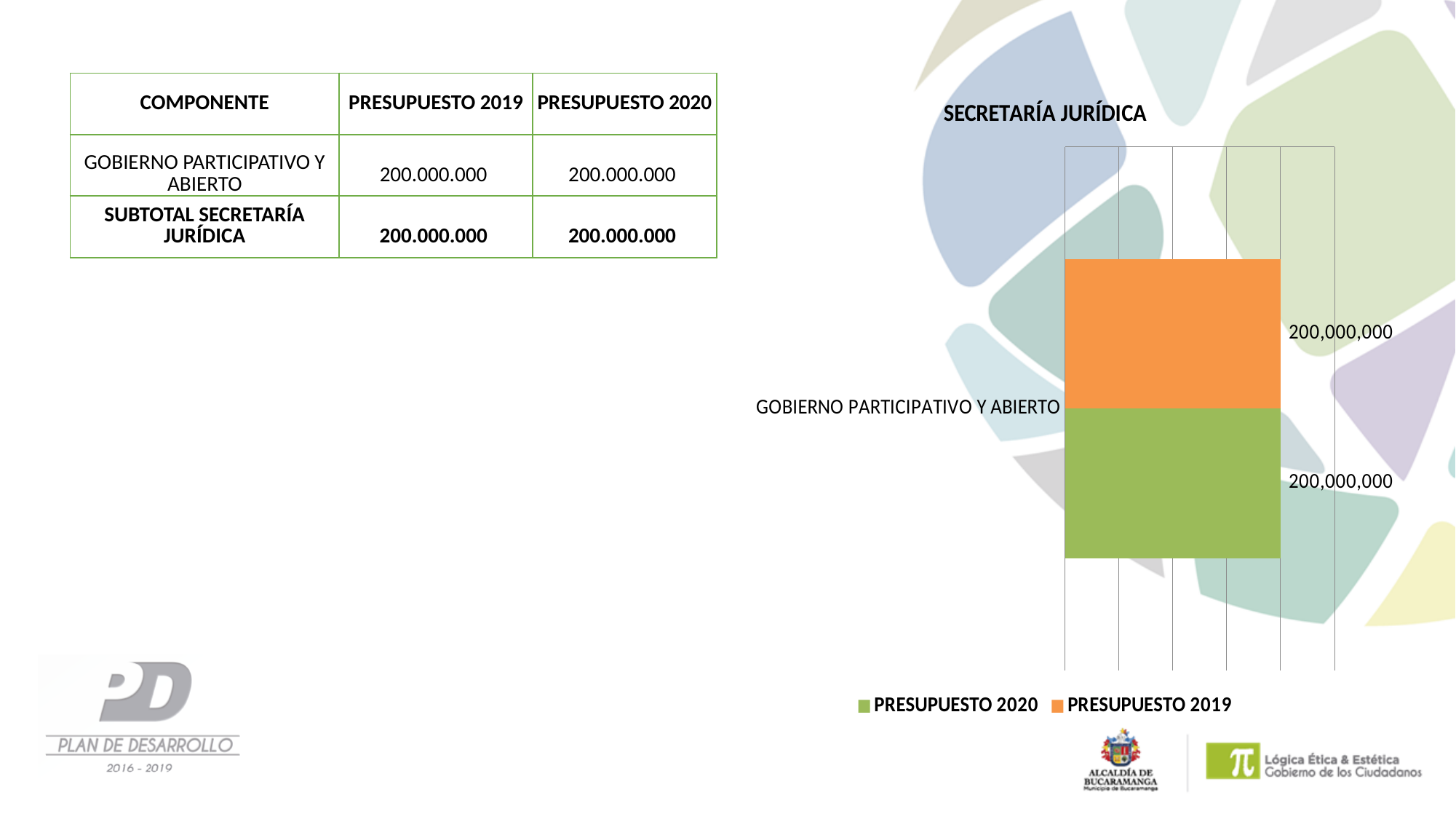
Which series is shown in orange in the chart? PRESUPUESTO 2019 What is the difference between the PRESUPUESTO 2019 and PRESUPUESTO 2020 values for GOBIERNO PARTICIPATIVO Y ABIERTO? 0 What kind of chart is shown on the slide? Bar chart (horizontal bars) How many categories are plotted on the x axis of the chart? 1 What is the name of the only category shown in the chart? GOBIERNO PARTICIPATIVO Y ABIERTO What is the value of PRESUPUESTO 2020 for GOBIERNO PARTICIPATIVO Y ABIERTO in the chart? 200,000,000 Which colour represents PRESUPUESTO 2020 in the chart? Green What is the title of the chart? SECRETARÍA JURÍDICA What is the value of PRESUPUESTO 2019 for GOBIERNO PARTICIPATIVO Y ABIERTO in the chart? 200,000,000 How many series does the chart legend list? 2